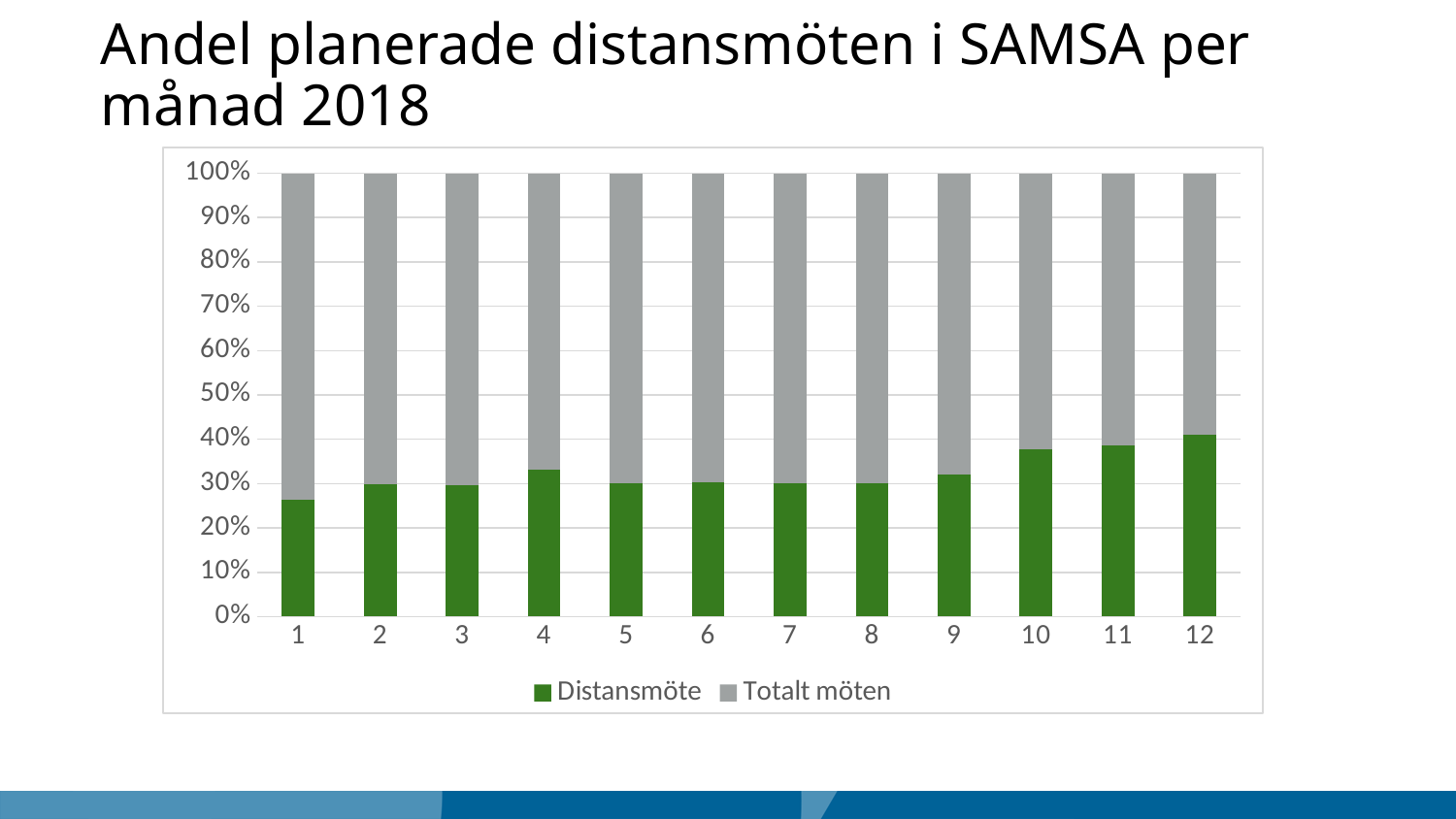
Is the Distansmöte share for month 4 greater or less than 30%? greater Which month has the highest share for Distansmöte? 12 Is the Distansmöte share for month 12 greater or less than 40%? greater Is the Distansmöte share for month 1 greater or less than 30%? less How many series does the legend list? 2 How many months (categories) are shown on the x axis? 12 Which month has a larger Distansmöte share, month 1 or month 12? 12 Which month has the lowest share for Distansmöte? 1 Does the Distansmöte share generally rise or fall from month 1 to month 12? rise What kind of chart is shown on the slide? Stacked bar chart Which colour represents Distansmöte in the legend? Green